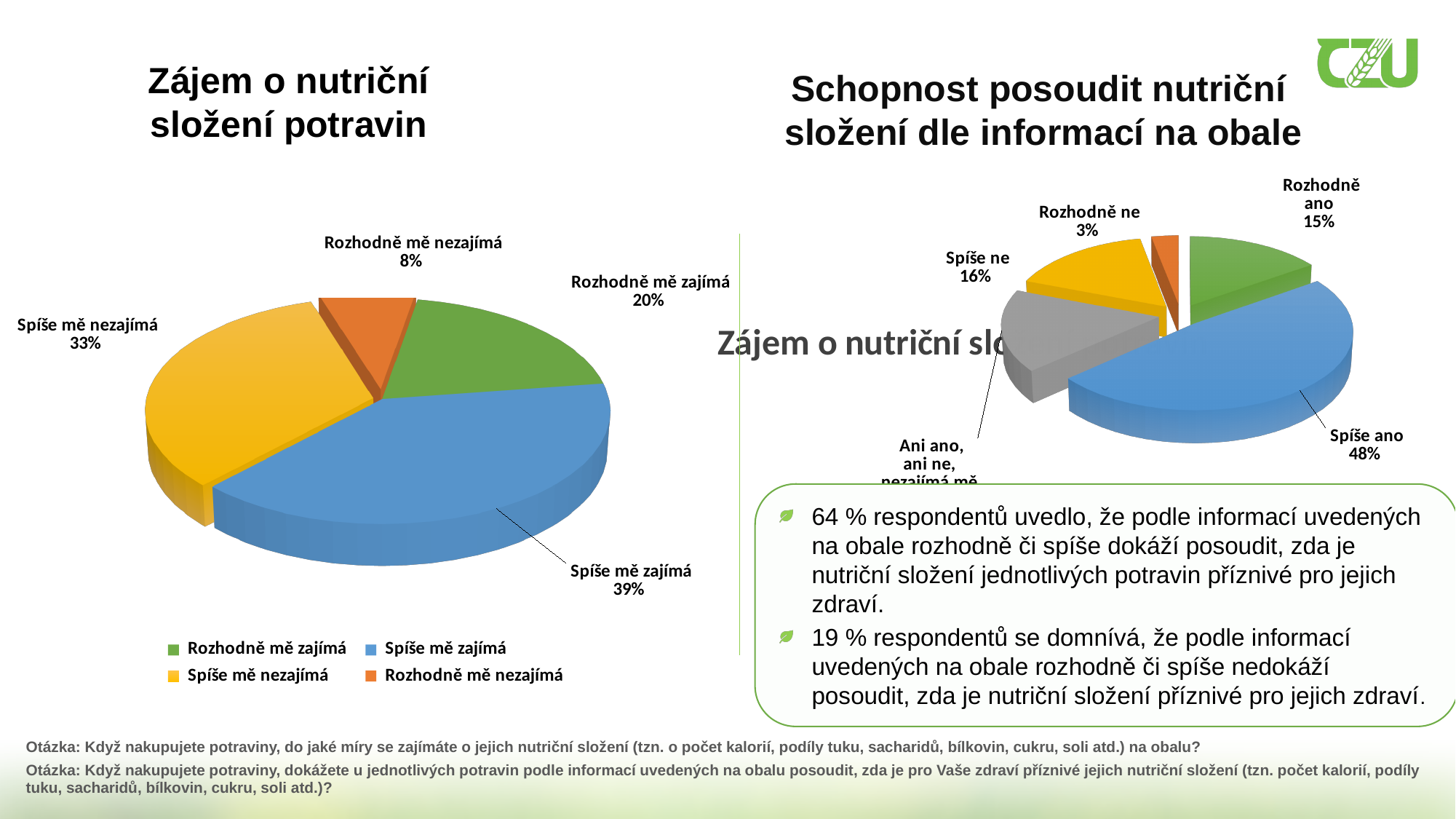
How many entries does the legend of the 'Zájem o nutriční složení potravin' chart list? 4 How many slices does the 'Schopnost posoudit nutriční složení dle informací na obale' pie chart have? 5 In the 'Zájem o nutriční složení potravin' chart, which category has the largest share? Spíše mě zajímá In the 'Zájem o nutriční složení potravin' chart, what is the difference between 'Spíše mě nezajímá' and 'Rozhodně mě zajímá'? 13% In the 'Schopnost posoudit nutriční složení dle informací na obale' chart, which is larger, 'Rozhodně ano' or 'Spíše ne'? Spíše ne In the 'Zájem o nutriční složení potravin' chart, what share is 'Rozhodně mě nezajímá'? 8% In the 'Zájem o nutriční složení potravin' chart, what share is 'Spíše mě zajímá'? 39% In the 'Zájem o nutriční složení potravin' chart, what colour is the 'Spíše mě nezajímá' slice? yellow In the 'Schopnost posoudit nutriční složení dle informací na obale' chart, what share is 'Spíše ano'? 48% In the 'Zájem o nutriční složení potravin' chart, which category has the smallest share? Rozhodně mě nezajímá In the 'Schopnost posoudit nutriční složení dle informací na obale' chart, what share is 'Rozhodně ne'? 3% What kind of chart is the 'Zájem o nutriční složení potravin' chart? pie chart